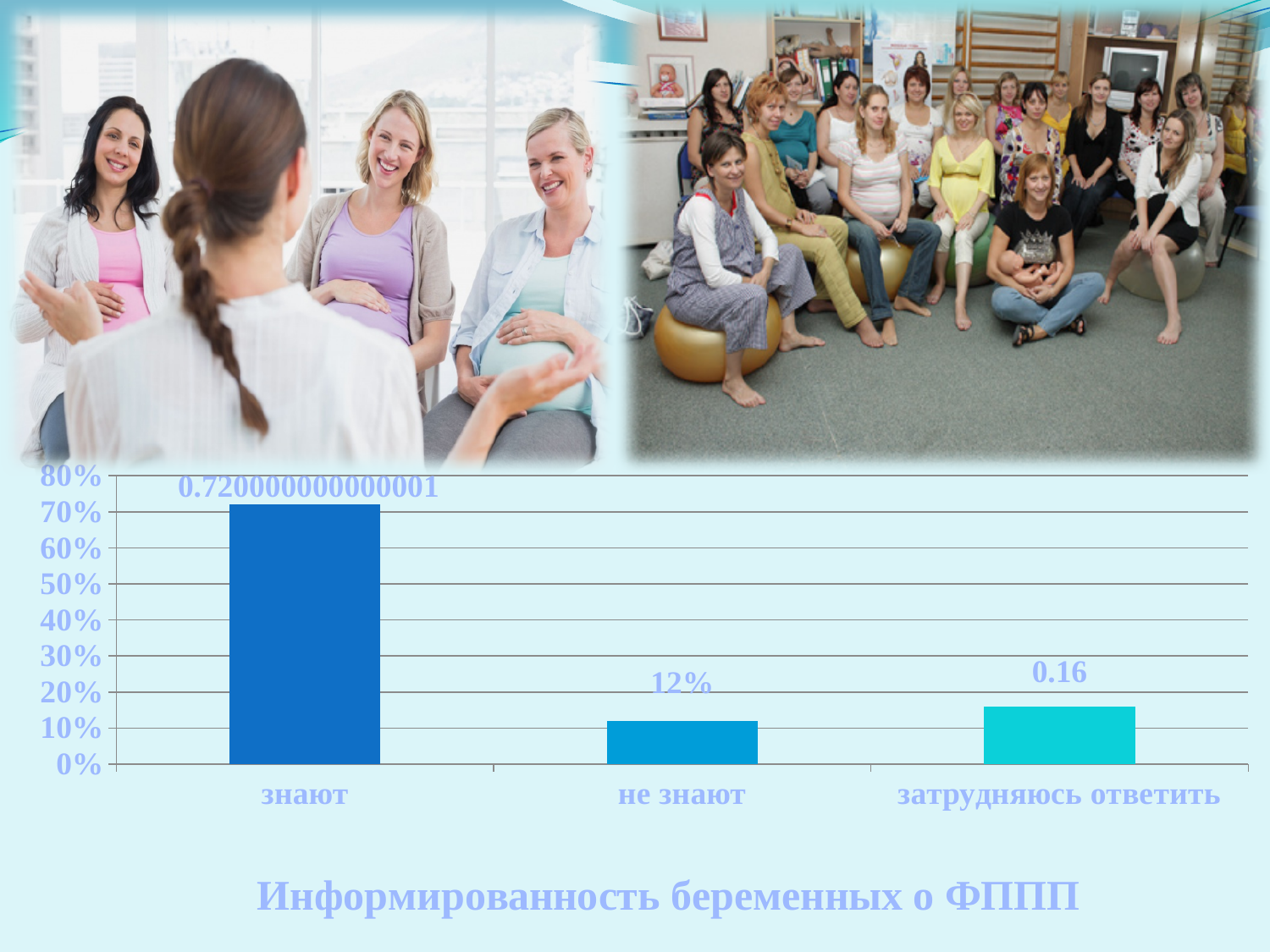
How many categories are shown on the x axis of the chart? 3 Which bar is taller: "не знают" or "затрудняюсь ответить"? затрудняюсь ответить Is the value for "затрудняюсь ответить" greater or less than 20%? less What data label is printed above the bar for "не знают"? 12% What kind of chart is shown on the slide? bar chart What data label is printed above the bar for "затрудняюсь ответить"? 0.16 What is the highest value shown on the y axis of the chart? 80% Which category has the highest bar? знают Is the value for "знают" greater or less than 50%? greater What is the title of the chart? Информированность беременных о ФППП Which category has the lowest bar? не знают What data label is printed above the bar for "знают"? 0.720000000000001